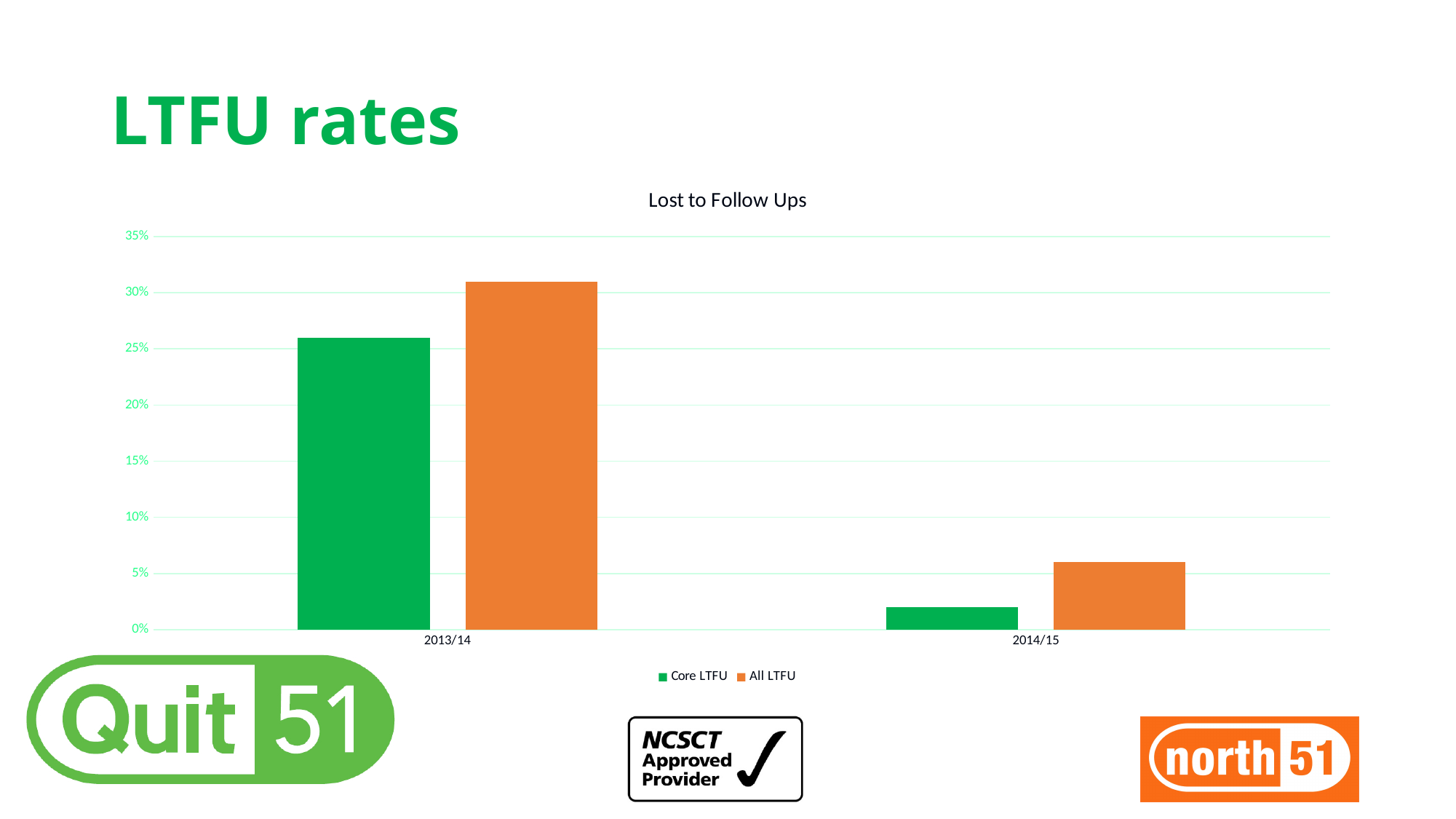
What type of chart is shown on the slide? bar chart Is the value for All LTFU in 2013/14 greater or less than 30%? greater Is the value for All LTFU in 2014/15 greater or less than 10%? less How many series does the legend list? 2 How many categories are shown on the x axis? 2 Which series is shown in orange? All LTFU What is the title of the chart? Lost to Follow Ups Which year has the highest All LTFU value? 2013/14 Which is larger in 2013/14, Core LTFU or All LTFU? All LTFU Is the value for Core LTFU in 2013/14 greater or less than 25%? greater Do the Core LTFU values rise or fall from 2013/14 to 2014/15? fall